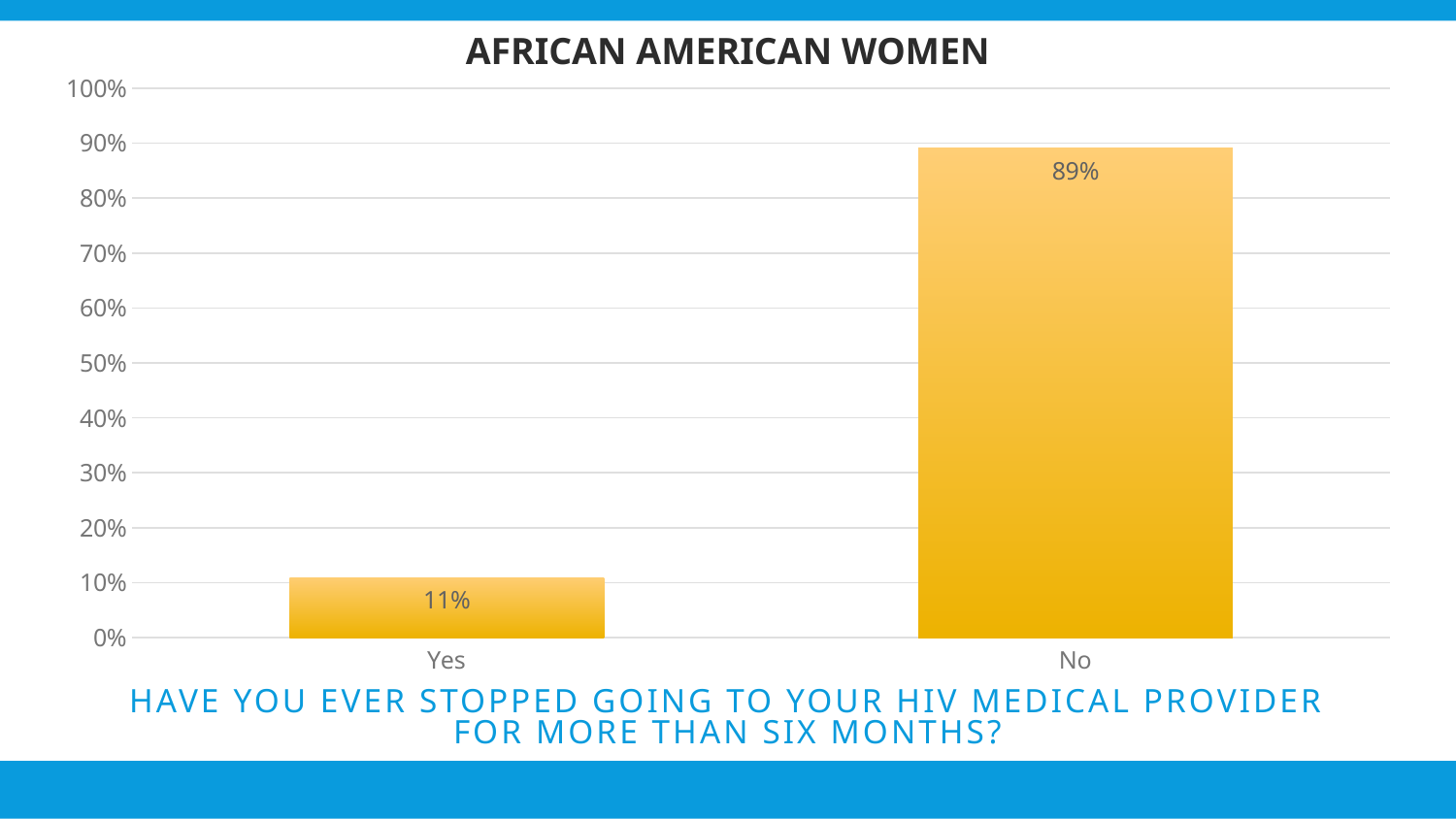
Which response category has the highest value? No Is the value for "Yes" greater or less than 20%? less What percentage of respondents answered "No"? 89% What is the title of the chart? AFRICAN AMERICAN WOMEN Which is larger, the value for "Yes" or the value for "No"? No What is the maximum value shown on the y axis? 100% How many response categories are shown on the x axis? 2 What kind of chart is shown on the slide? Bar chart Which response category has the lowest value? Yes What percentage of respondents answered "Yes"? 11% Is the value for "No" greater or less than 80%? greater What is the difference between the "No" and "Yes" percentages? 78%